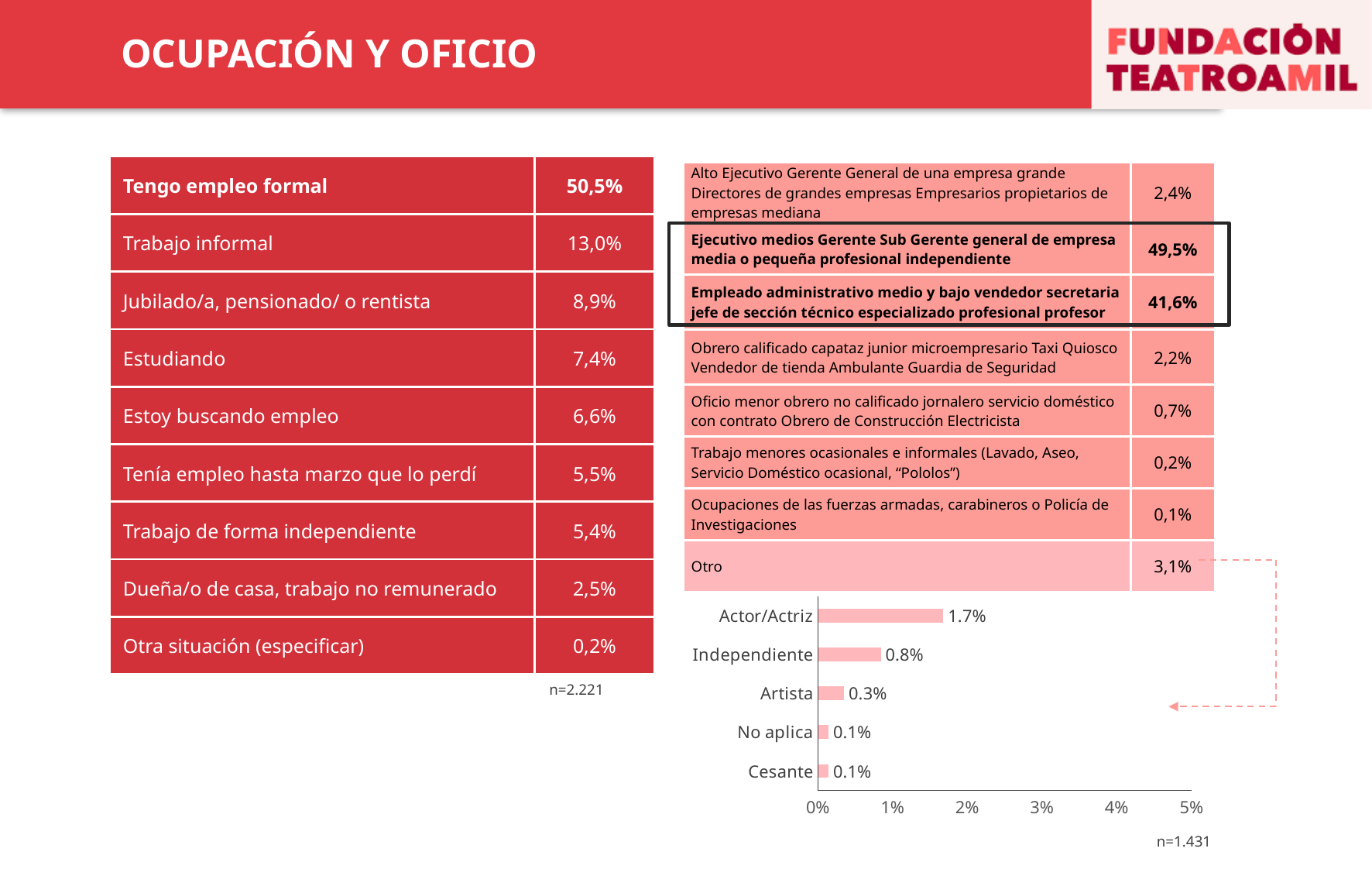
What is the difference between the values for Actor/Actriz and Independiente in the bar chart? 0.9% What is the value for Cesante in the bar chart? 0.1% What kind of chart is shown at the bottom right of the slide? bar chart What is the value for Artista in the bar chart? 0.3% What is the highest value shown on the x axis of the bar chart? 5% Is the value for Actor/Actriz in the bar chart greater or less than 1%? greater Is the value for Independiente in the bar chart greater or less than 1%? less Which category has the highest value in the bar chart? Actor/Actriz What is the value for Actor/Actriz in the bar chart? 1.7% Which is larger in the bar chart, the value for Independiente or the value for Artista? Independiente What is the value for Independiente in the bar chart? 0.8% How many categories are shown in the bar chart? 5